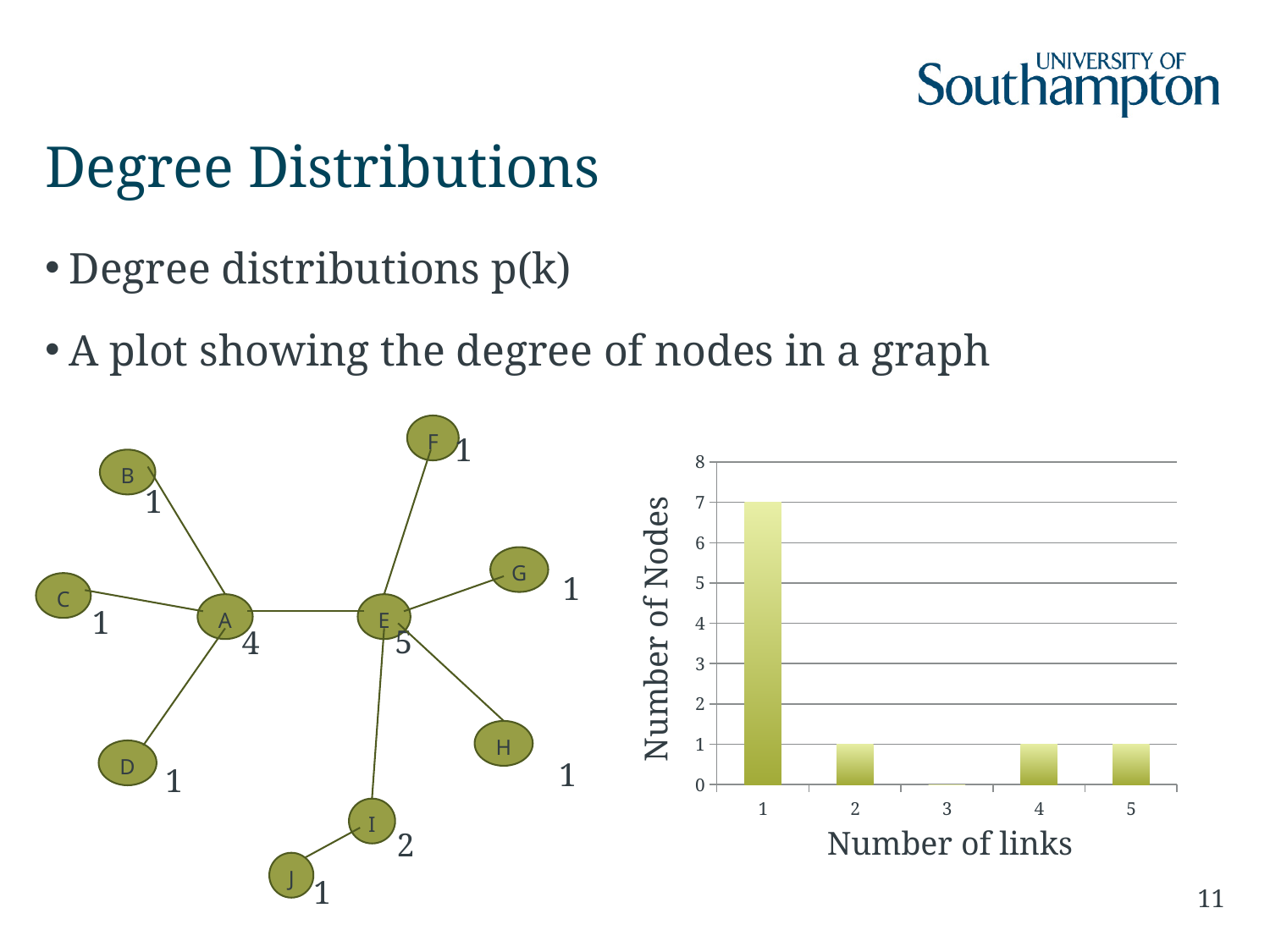
How many categories are shown on the x axis of the chart? 5 Which number of links has the highest number of nodes? 1 What is the label of the y axis of the chart? Number of Nodes Which has more nodes: 1 link or 2 links? 1 link How many nodes have 2 links according to the chart? 1 What is the difference between the number of nodes with 1 link and the number of nodes with 4 links? 6 Which number of links has the lowest number of nodes? 3 What kind of chart is shown on the slide? bar chart How many nodes have 5 links according to the chart? 1 How many nodes have 3 links according to the chart? 0 What is the label of the x axis of the chart? Number of links How many nodes have 1 link according to the chart? 7